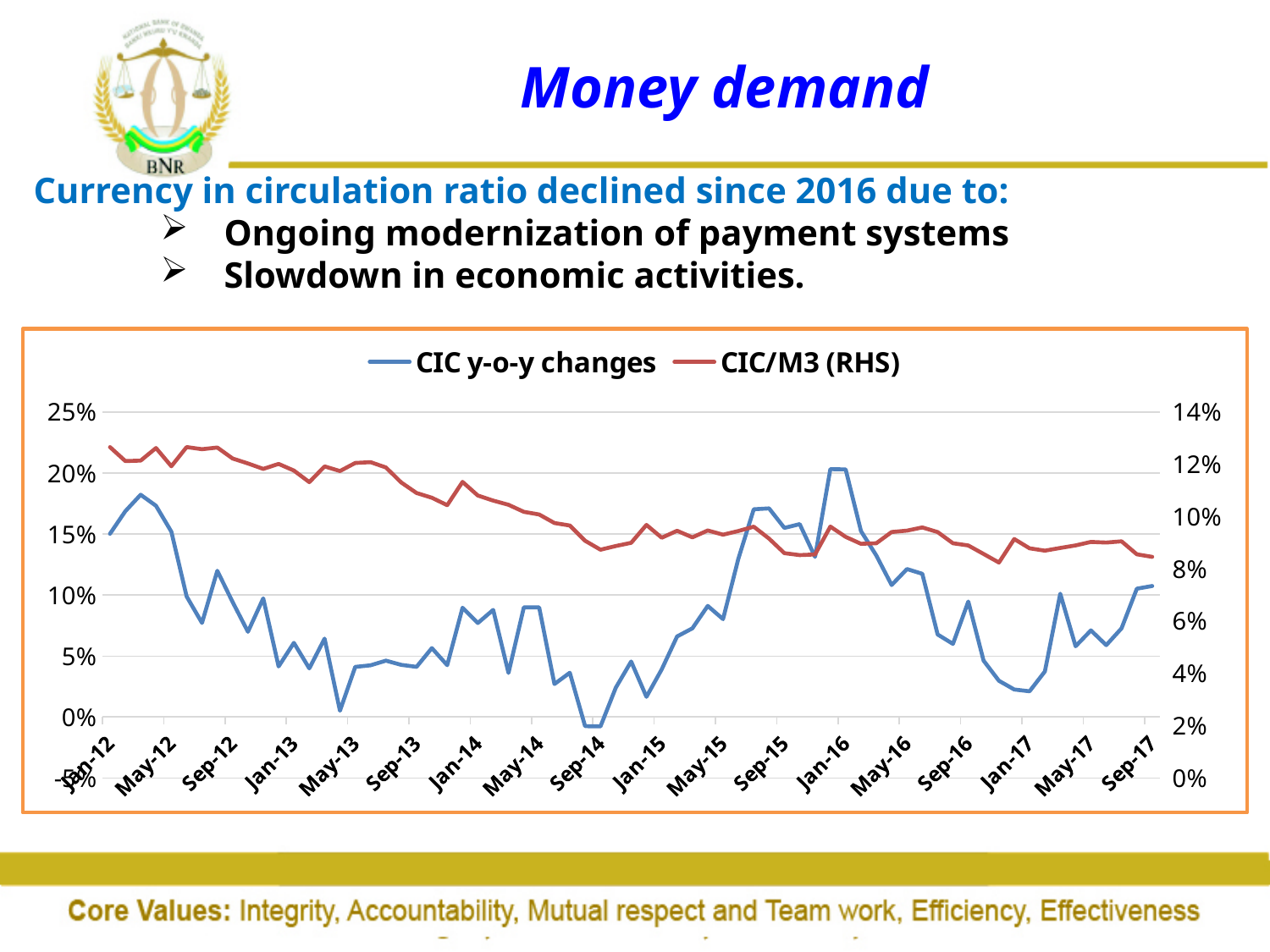
What colour is the line for CIC y-o-y changes? blue How many date labels are shown on the x axis? 18 At which x-axis label does the CIC y-o-y changes line reach its highest point? Jan-16 Is the value of CIC y-o-y changes at Sep-14 greater or less than 5%? less Is the value of CIC y-o-y changes at Jan-16 greater or less than 15%? greater Does the CIC/M3 (RHS) line generally rise or fall from Jan-12 to Sep-17? fall Which series is plotted on the right-hand axis according to the legend? CIC/M3 (RHS) Is the value of CIC/M3 (RHS) at Jan-12 greater or less than 10%? greater How many series does the legend list? 2 What kind of chart is shown on the slide? line chart Does the CIC y-o-y changes line rise or fall from Jan-16 to Jan-17? fall